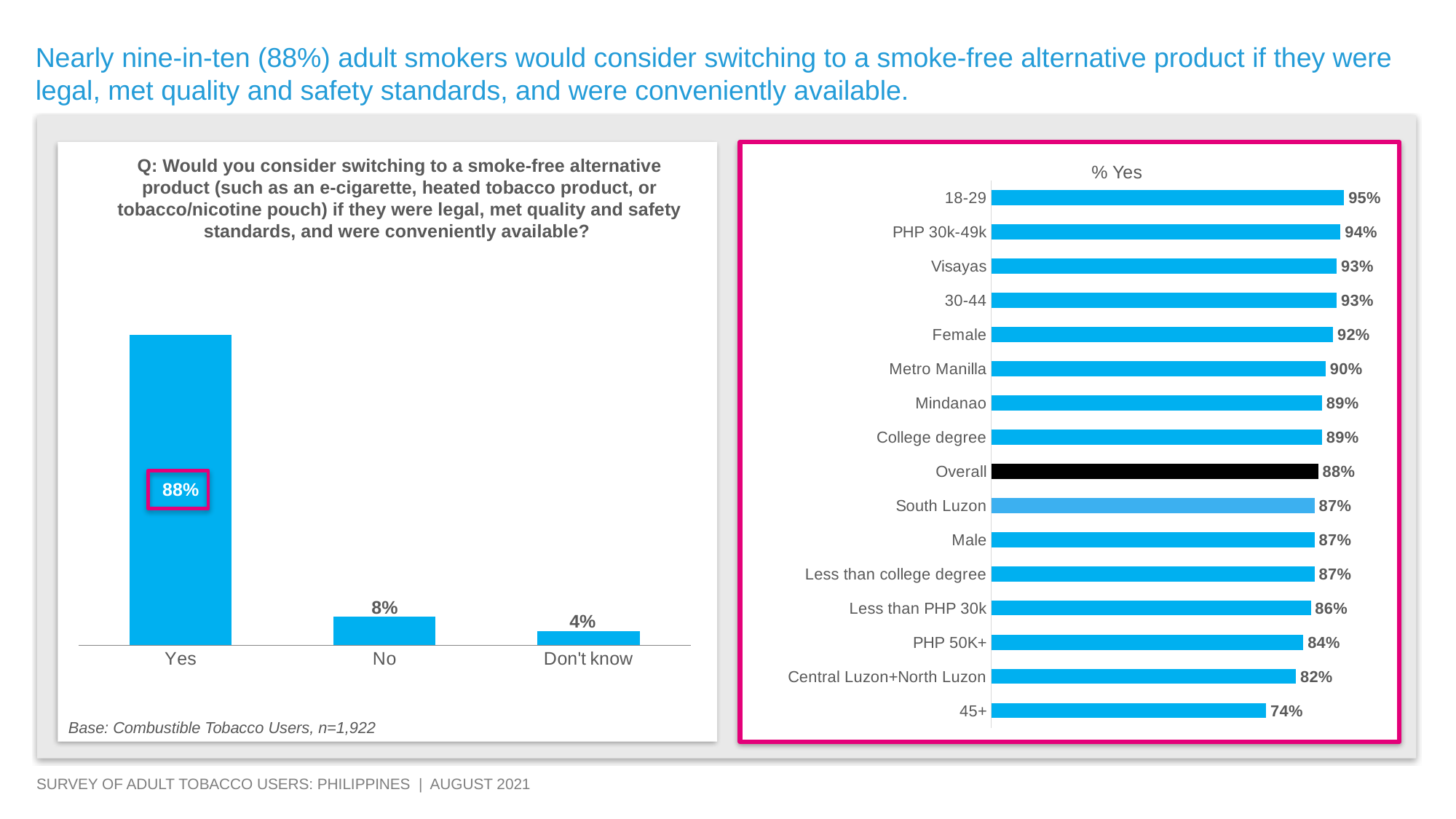
In the "% Yes" chart, which group has the highest value? 18-29 In the "% Yes" chart, what is the value for Metro Manilla? 90% In the "% Yes" chart, what is the difference between the values for 18-29 and 45+? 21 percentage points How many response categories are shown in the left chart? 3 In the "% Yes" chart, what is the value for Central Luzon+North Luzon? 82% How many groups are listed in the "% Yes" chart? 16 In the "% Yes" chart, which group has the lowest value? 45+ What kind of chart is the "% Yes" chart on the right? Bar chart In the left chart, what percentage of respondents answered "Yes"? 88% In the "% Yes" chart, which is larger: the value for Female or the value for Male? Female In the left chart, what is the difference between the "Yes" and "No" percentages? 80 percentage points In the left chart, what percentage of respondents answered "Don't know"? 4%